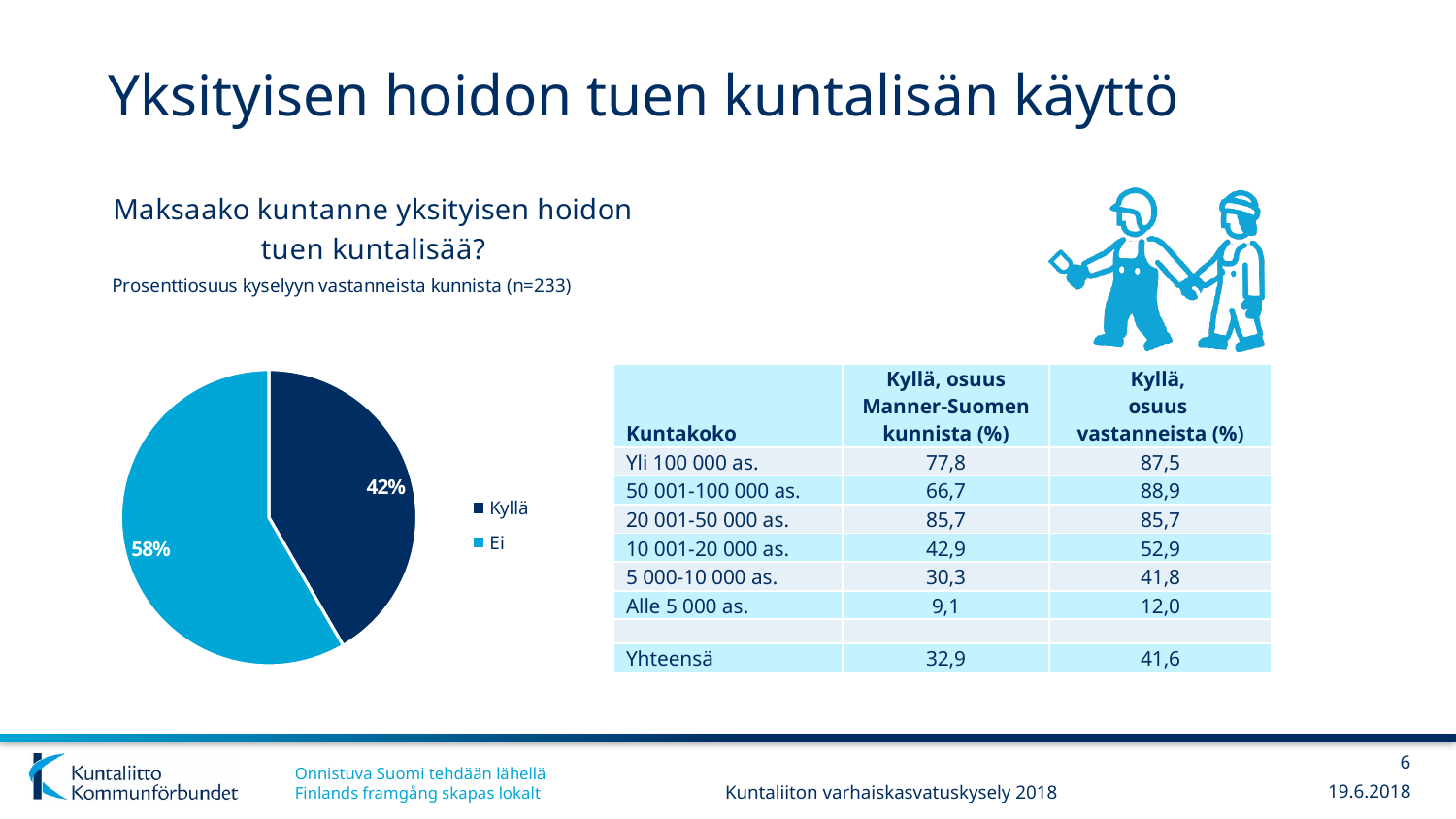
What is the title of the pie chart? Maksaako kuntanne yksityisen hoidon tuen kuntalisää? Which legend entry of the pie chart is shown in dark navy blue? Kyllä How many entries does the pie chart's legend list? 2 What percentage does the Kyllä slice of the pie chart show? 42% Which slice of the pie chart is the largest? Ei What share of the pie chart does the Kyllä slice represent? 42% What percentage does the Ei slice of the pie chart show? 58% Which is larger in the pie chart, Kyllä or Ei? Ei How many slices does the pie chart have? 2 What is the difference in percentage points between the Ei and Kyllä slices of the pie chart? 16 What kind of chart is shown on the slide? pie chart Which slice of the pie chart is the smallest? Kyllä